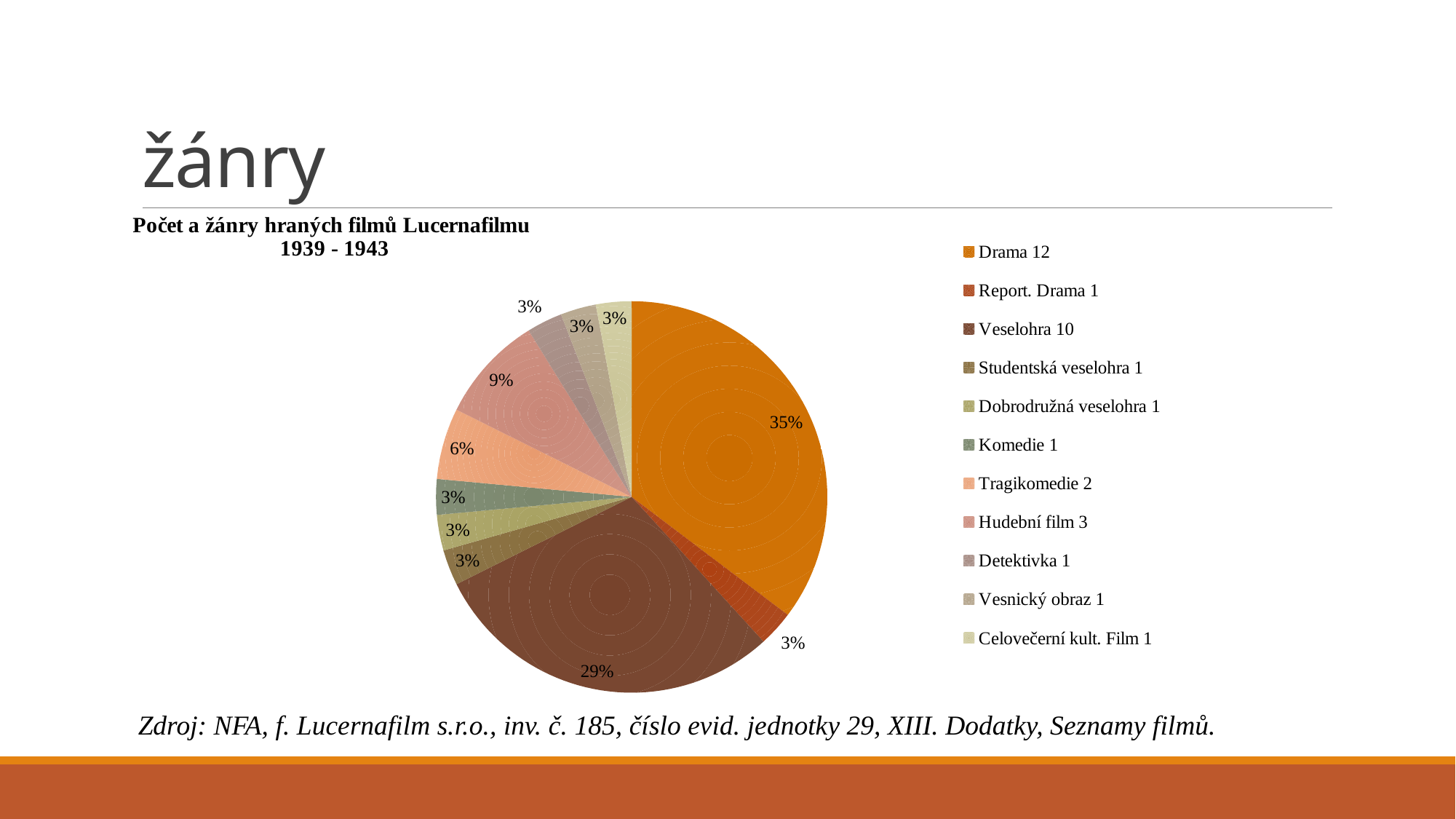
What share of the pie does Hudební film represent? 9% Which slice is larger, Drama or Veselohra? Drama What is the title of the chart? Počet a žánry hraných filmů Lucernafilmu 1939 - 1943 According to the legend, how many films are listed for Drama? 12 What is the difference in percentage points between the Drama slice and the Veselohra slice? 6 What kind of chart is shown on the slide? pie chart How many genre categories does the legend list? 11 According to the legend, how many films are listed for Hudební film? 3 Which genre has the largest slice of the pie? Drama What share of the pie does Drama represent? 35% What share of the pie does Tragikomedie represent? 6%